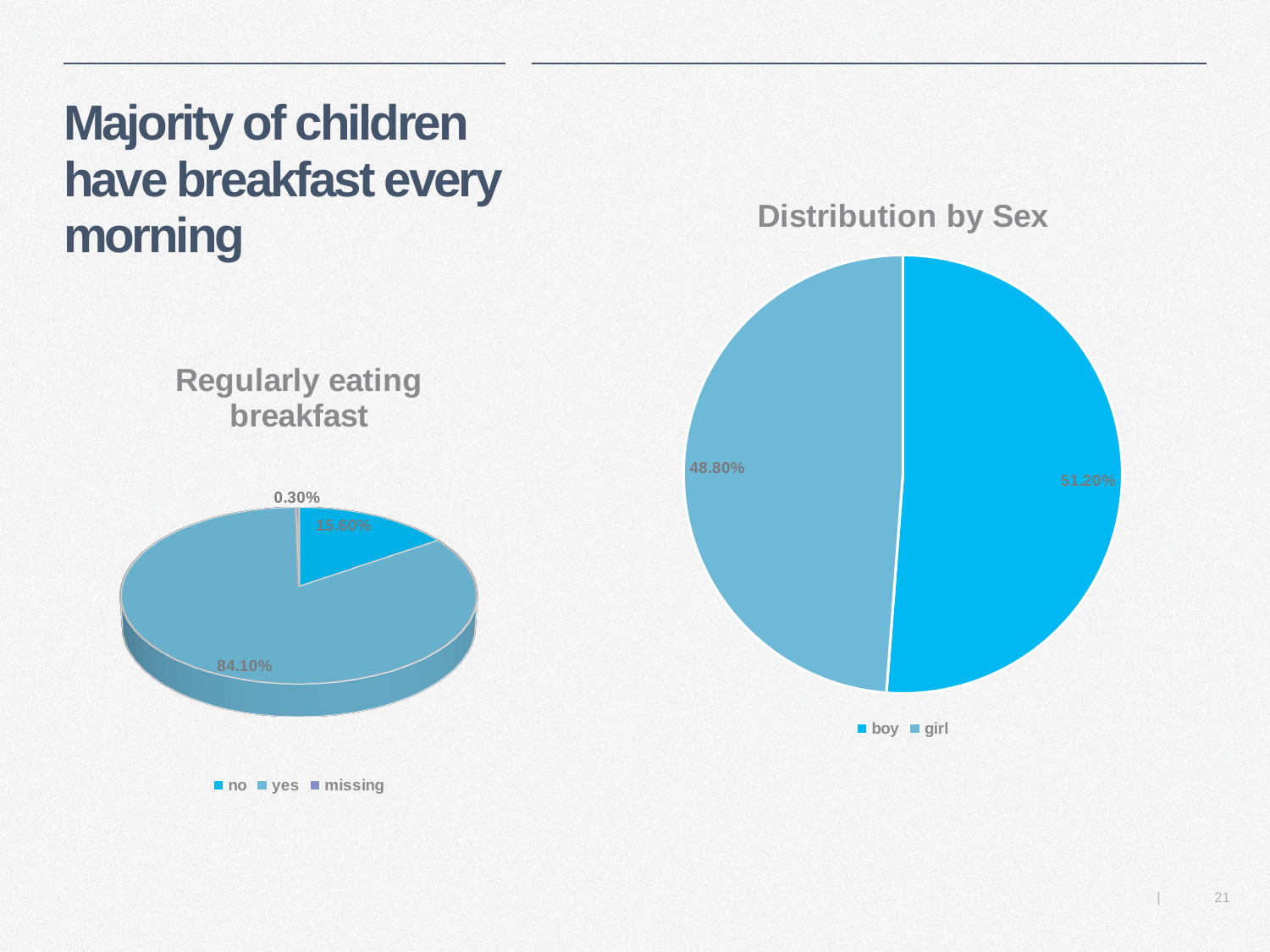
In the 'Distribution by Sex' chart, which group has the larger share, boy or girl? boy In the 'Distribution by Sex' chart, what is the difference between the boy and girl percentages? 2.40% In the 'Regularly eating breakfast' chart, what is the difference between the 'yes' and 'no' percentages? 68.50% In the 'Distribution by Sex' chart, what percentage is labelled for girls? 48.80% How many categories does the legend of the 'Regularly eating breakfast' chart list? 3 In the 'Regularly eating breakfast' chart, which category has the largest share? yes In the 'Regularly eating breakfast' chart, what percentage of children answered 'yes'? 84.10% In the 'Regularly eating breakfast' chart, what percentage of children answered 'no'? 15.60% In the 'Regularly eating breakfast' chart, what percentage is labelled as 'missing'? 0.30% In the 'Distribution by Sex' chart, what percentage is labelled for boys? 51.20% In the 'Regularly eating breakfast' chart, which category has the smallest share? missing What type of chart is the 'Distribution by Sex' chart? pie chart